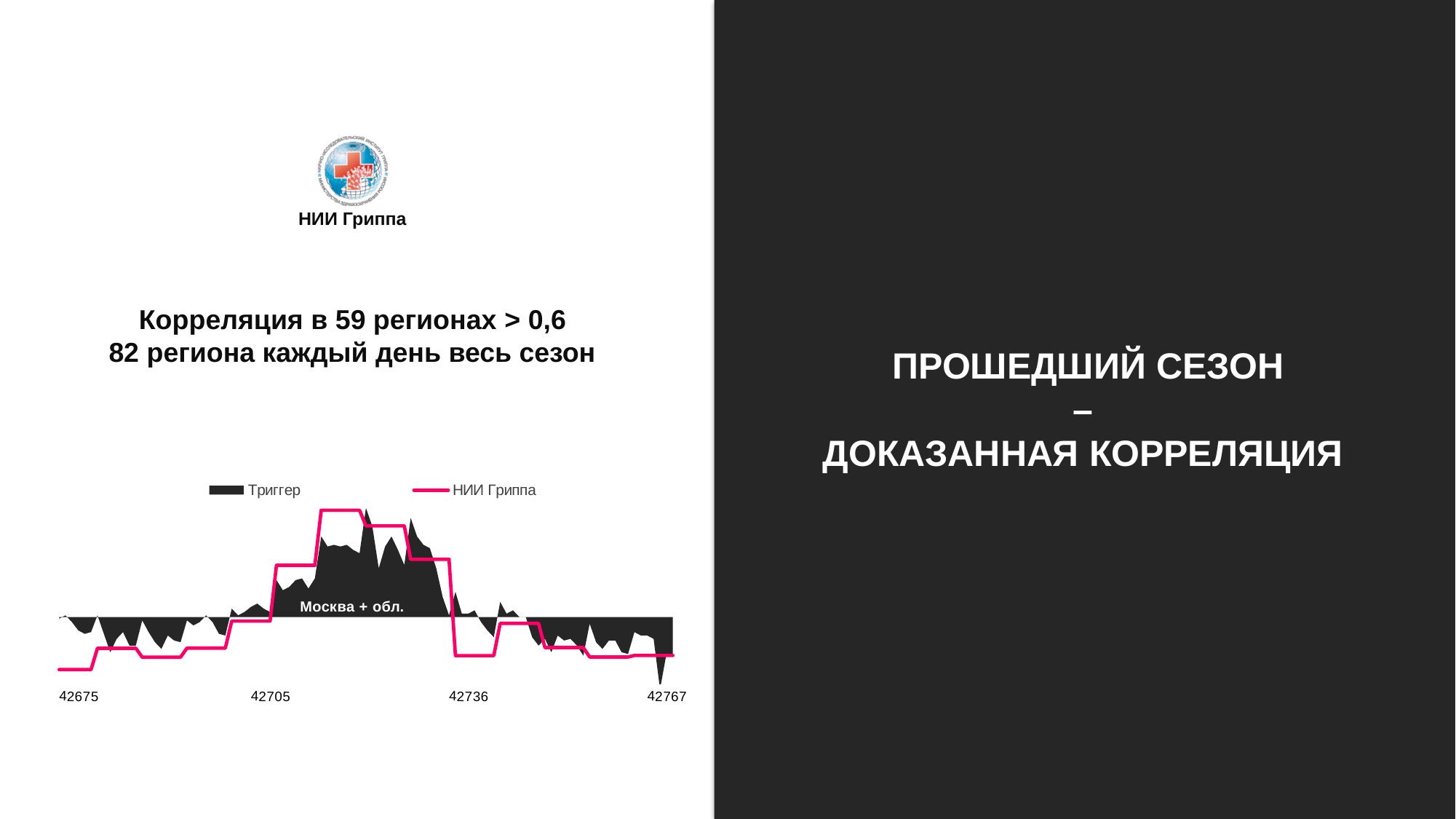
What is the last tick label on the chart's x axis? 42767 How many tick labels are shown on the chart's x axis? 4 Does the Триггер series reach its peak before or after the x-axis tick 42736? Before Which series in the chart is drawn in pink? НИИ Гриппа What kind of chart is shown on the slide? Area chart with a line series What is the first tick label on the chart's x axis? 42675 What are the two series named in the chart legend? Триггер and НИИ Гриппа Does the НИИ Гриппа line rise or fall between the x-axis ticks 42705 and 42736 overall? It rises to a peak and then falls How many series does the chart legend list? 2 What region label is printed inside the chart's plot area? Москва + обл.